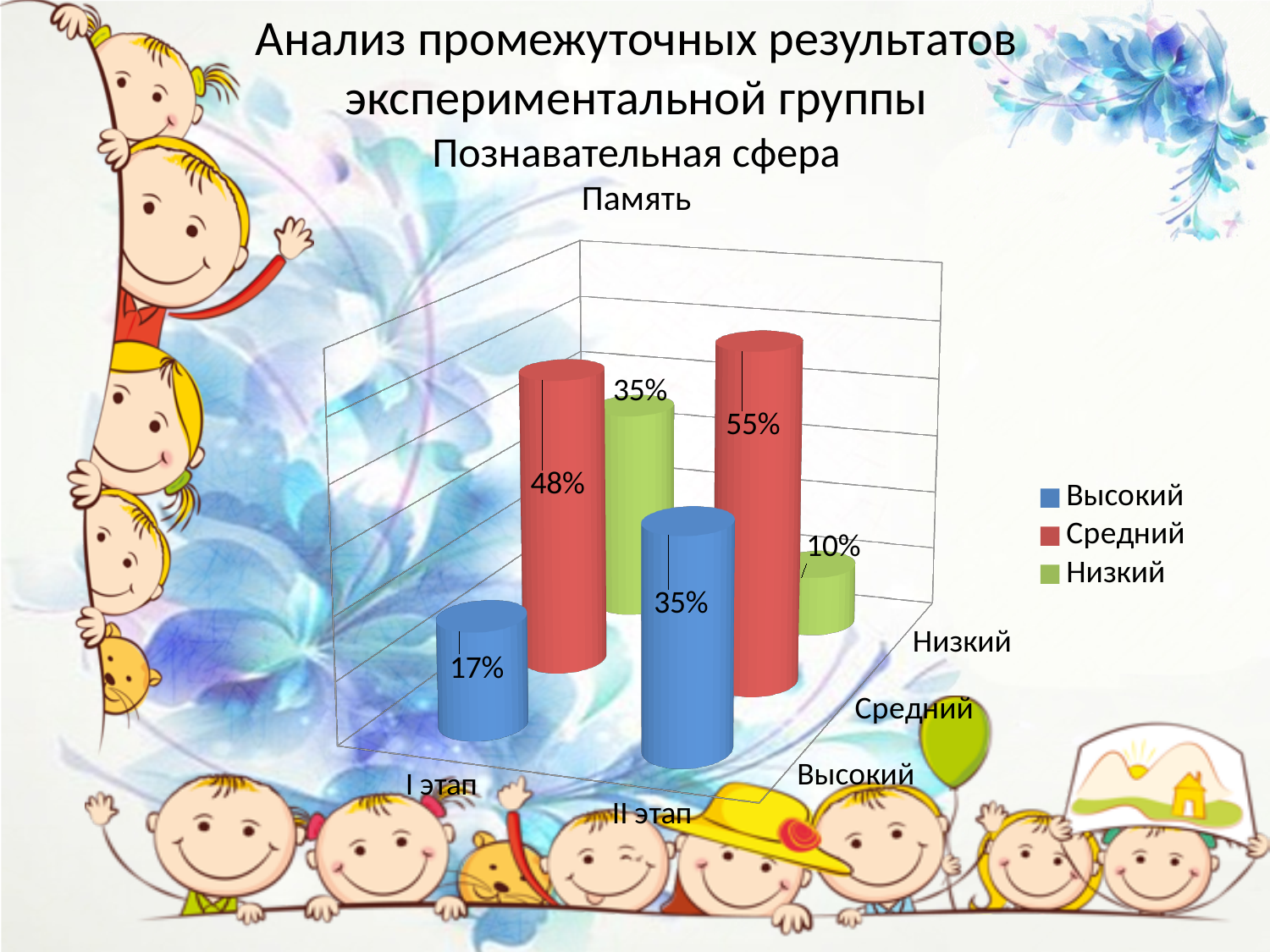
What kind of chart is the Память chart? bar chart Which is larger in the Память chart: Высокий at I этап or Высокий at II этап? Высокий at II этап How many series does the legend of the Память chart list? 3 What is the value for Низкий at II этап in the Память chart? 10% Does the Низкий series rise or fall from I этап to II этап in the Память chart? fall What is the value for Средний at II этап in the Память chart? 55% What is the value for Низкий at I этап in the Память chart? 35% Which series has the lowest value at I этап in the Память chart? Высокий Which series has the highest value at II этап in the Память chart? Средний How many stages (categories) are shown on the x axis of the Память chart? 2 What is the value for Высокий at I этап in the Память chart? 17% What is the difference between the Средний values at II этап and I этап in the Память chart? 7%